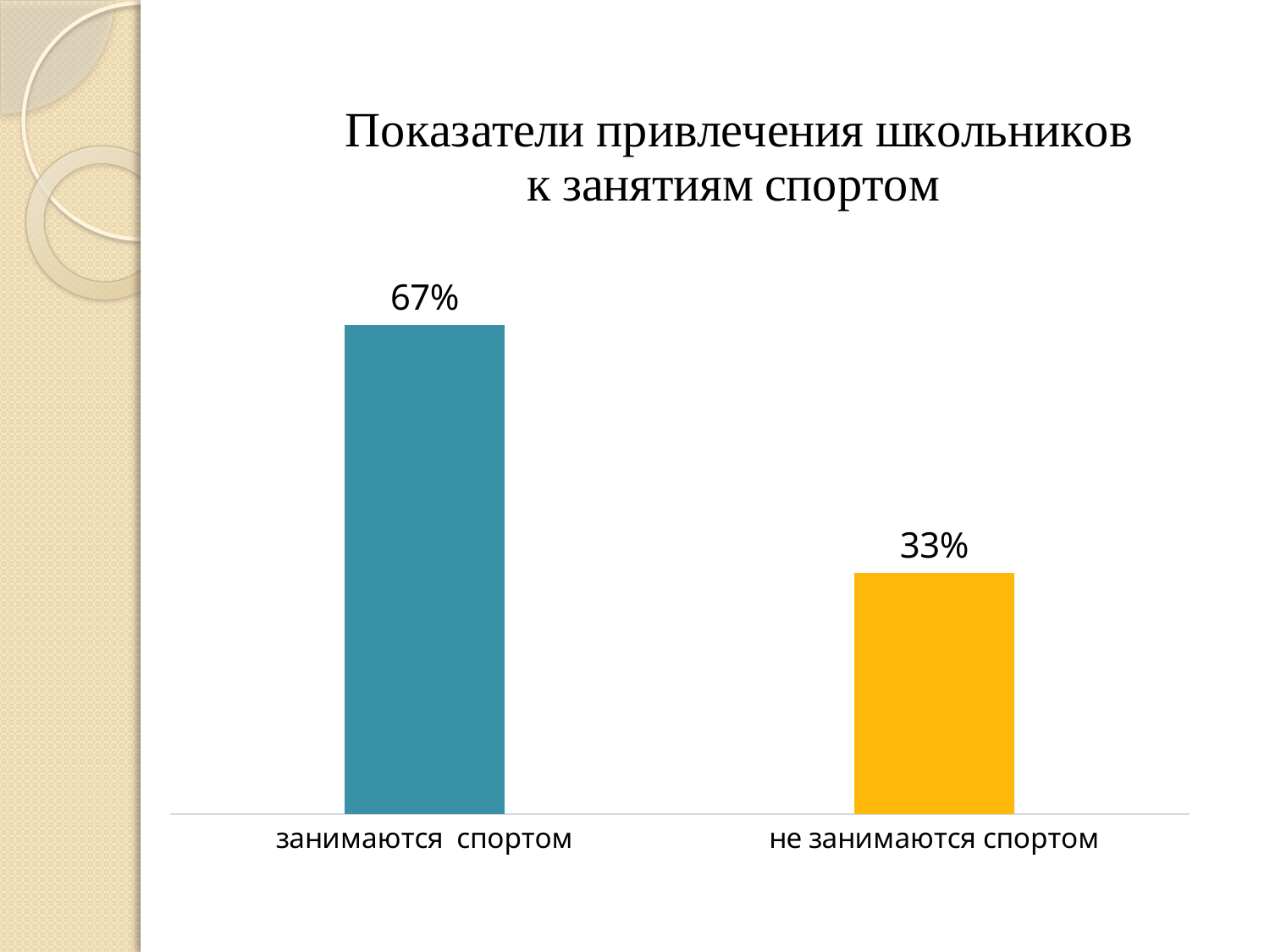
Which category has the lowest value? не занимаются спортом What is the value for "занимаются спортом"? 67% What is the total of the two values shown in the chart? 100% Which category has the highest value? занимаются спортом What is the title of the chart? Показатели привлечения школьников к занятиям спортом Which is larger: the value for "занимаются спортом" or for "не занимаются спортом"? занимаются спортом How many categories are shown in the chart? 2 What colour is the bar for "не занимаются спортом"? yellow What kind of chart is shown on the slide? bar chart What is the difference between the values for "занимаются спортом" and "не занимаются спортом"? 34% What is the value for "не занимаются спортом"? 33%